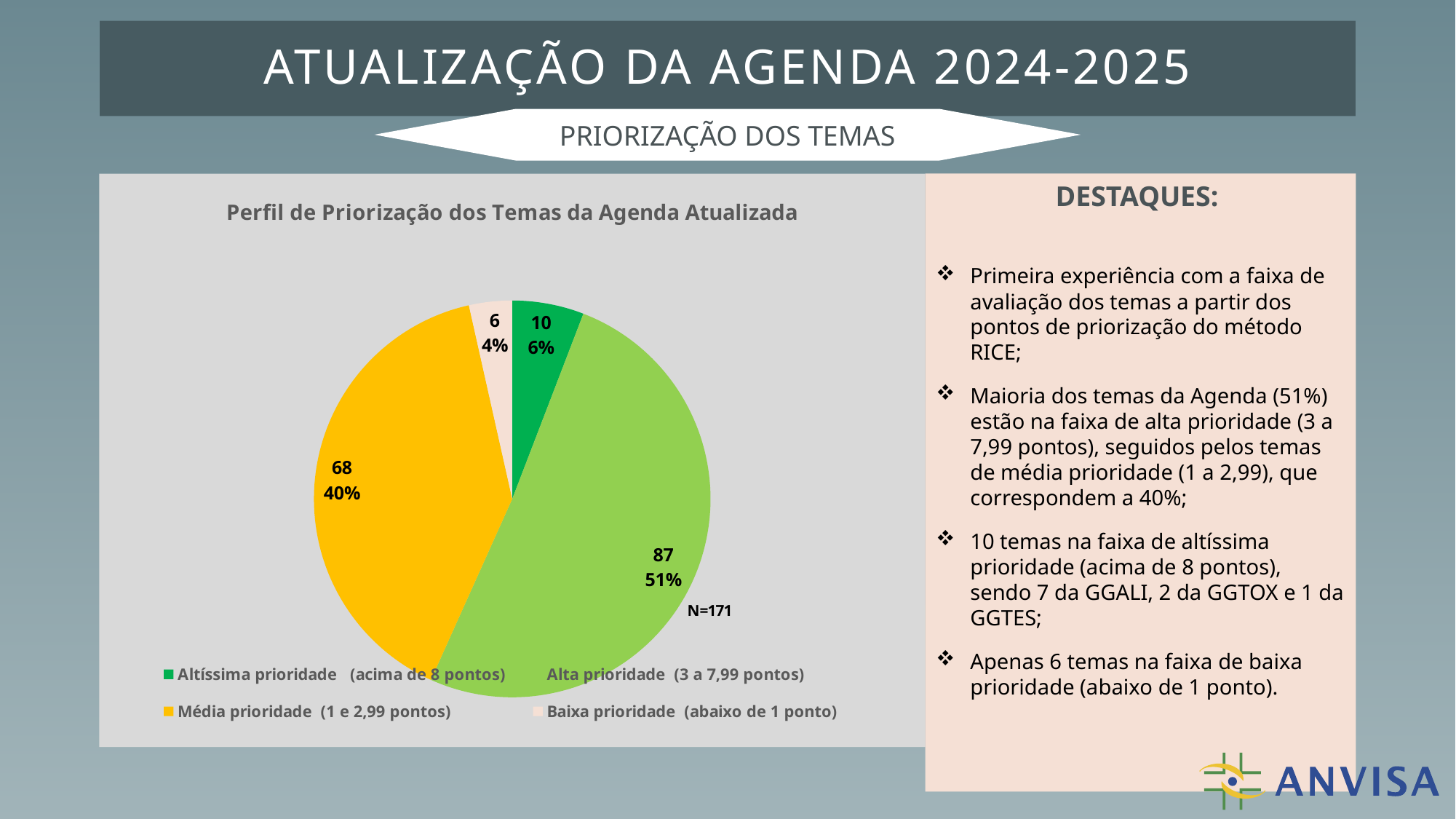
How many themes are in the 'Alta prioridade (3 a 7,99 pontos)' category? 87 What is the total number of themes (N) shown on the chart? N=171 Which category has the largest slice? Alta prioridade (3 a 7,99 pontos) Which has more themes, 'Altíssima prioridade' or 'Baixa prioridade'? Altíssima prioridade How many themes are in the 'Altíssima prioridade (acima de 8 pontos)' category? 10 What is the difference in number of themes between 'Alta prioridade' and 'Média prioridade'? 19 What percentage share does 'Média prioridade (1 e 2,99 pontos)' have? 40% What percentage share does 'Baixa prioridade (abaixo de 1 ponto)' have? 4% How many categories does the legend list? 4 What is the title of the chart? Perfil de Priorização dos Temas da Agenda Atualizada Which category has the smallest slice? Baixa prioridade (abaixo de 1 ponto) What kind of chart is shown on the slide? pie chart